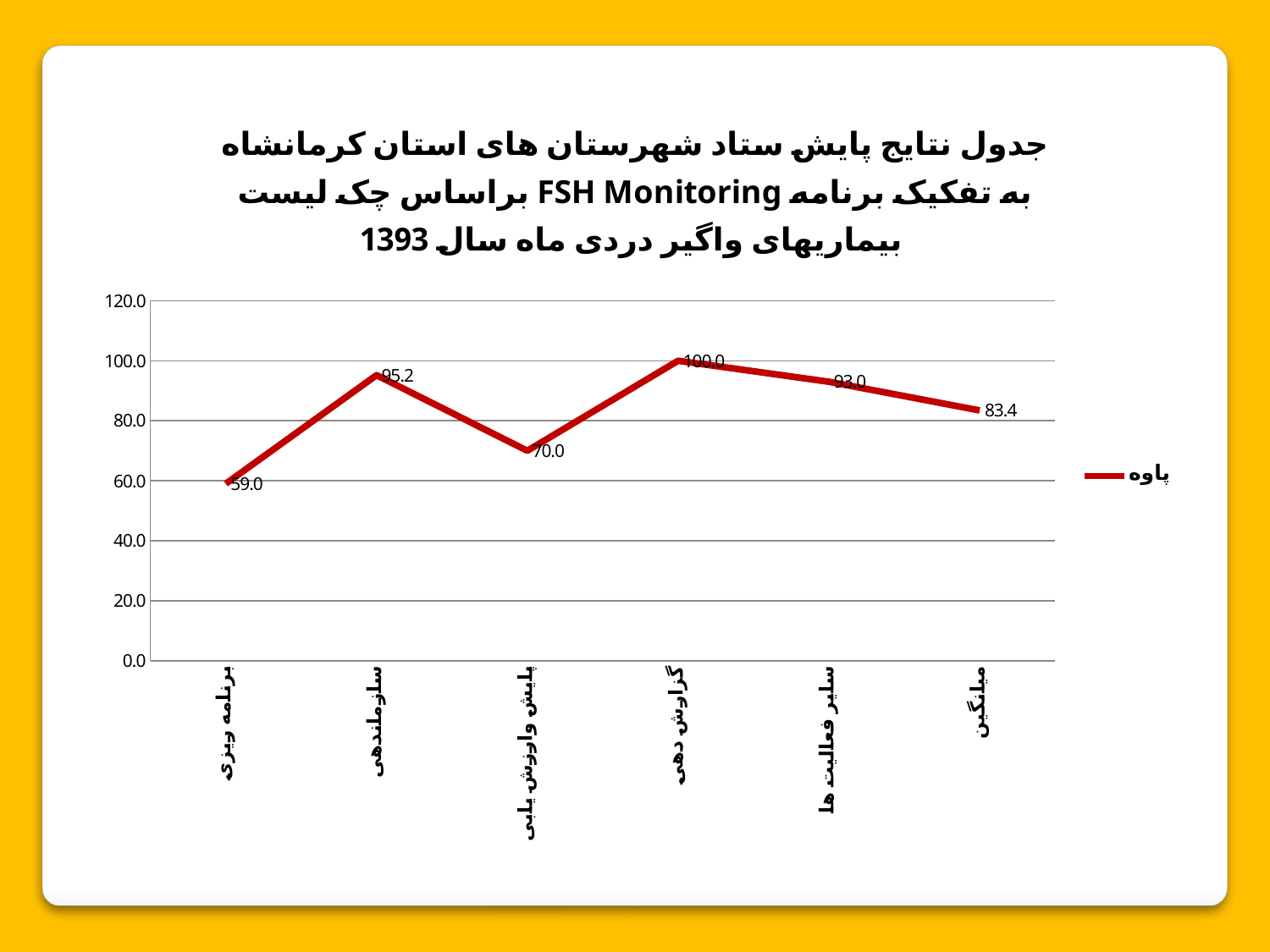
What is the value for میانگین? 83.4 How many series does the legend list? 1 Which category has the lowest value? برنامه ریزی What is the difference between the values for گزارش دهی and برنامه ریزی? 41.0 How many categories are plotted on the x axis? 6 What is the value for سازماندهی? 95.2 Which category has the highest value? گزارش دهی What type of chart is shown on the slide? line chart What is the value for گزارش دهی? 100.0 What is the value for برنامه ریزی? 59.0 Which is larger, the value for سازماندهی or the value for سایر فعالیت ها? سازماندهی What is the name of the series shown in the legend? پاوه